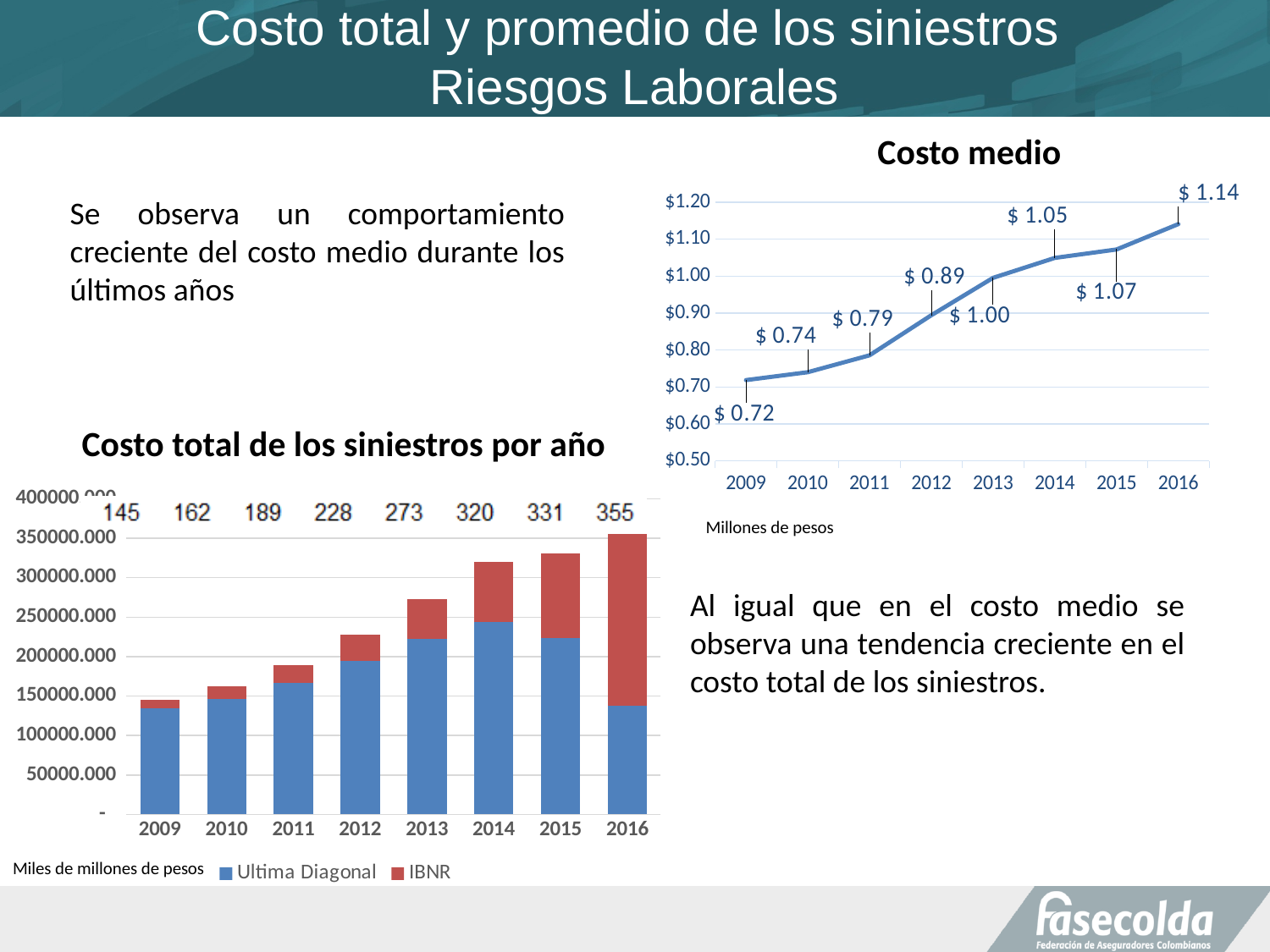
In the 'Costo total de los siniestros por año' chart, what is the total for 2012? 228 In the 'Costo medio' chart, what is the difference between the 2016 value and the 2009 value? $ 0.42 In the 'Costo medio' chart, which year has the lowest value? 2009 In the 'Costo medio' chart, what is the value for 2016? $ 1.14 In the 'Costo medio' chart, what is the value for 2013? $ 1.00 In the 'Costo total de los siniestros por año' chart, what is the total for 2016? 355 In the 'Costo medio' chart, do the values rise or fall from 2009 to 2016? rise In the 'Costo total de los siniestros por año' chart, how many series does the legend list? 2 In the 'Costo medio' chart, which year has the highest value? 2016 In the 'Costo total de los siniestros por año' chart, is the Ultima Diagonal value for 2014 greater or less than 200000.000? greater In the 'Costo medio' chart, what is the value for 2009? $ 0.72 What kind of chart is the 'Costo medio' chart? line chart